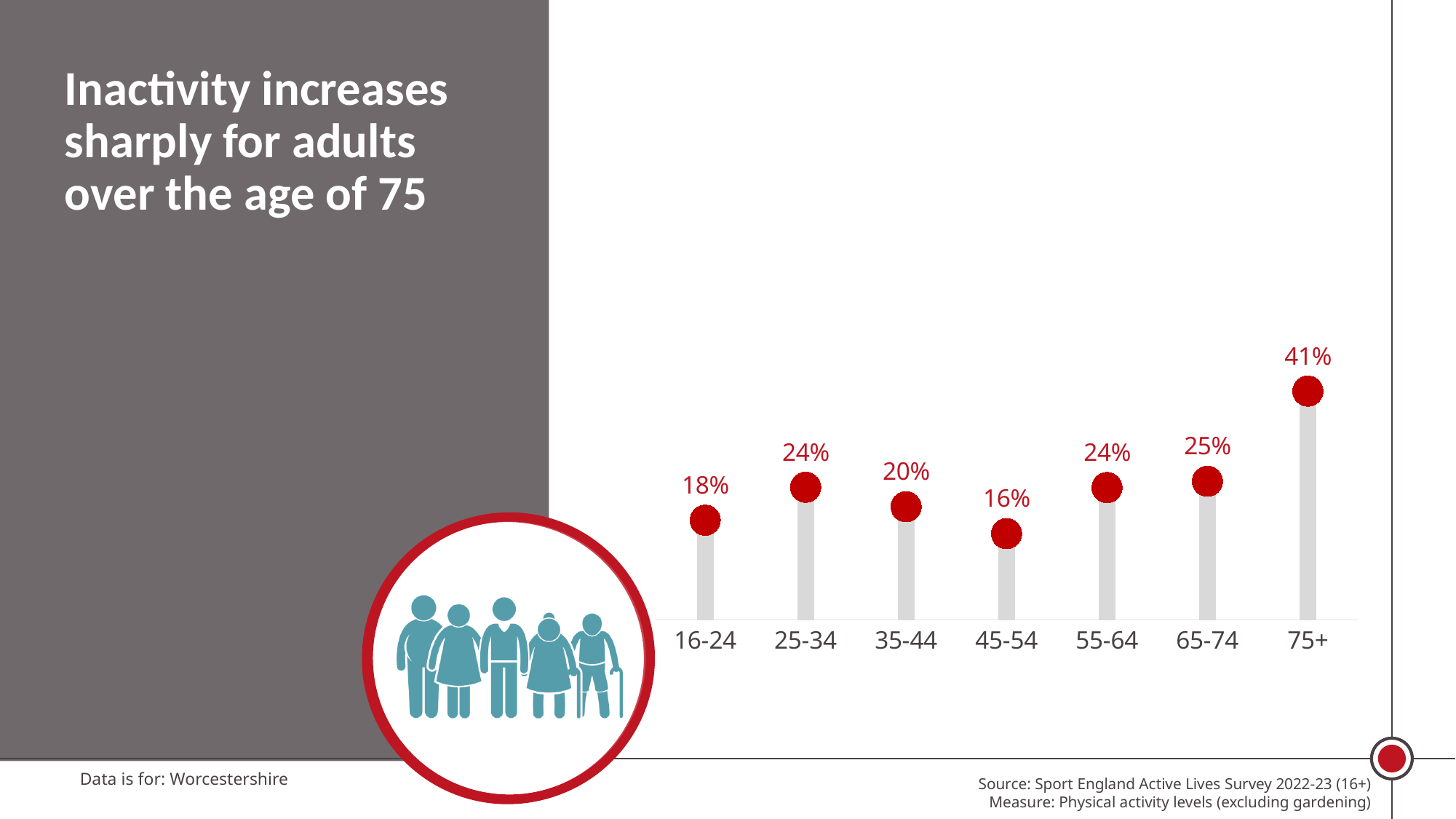
What kind of chart is shown on the slide? Bar chart How many age groups are shown on the chart? 7 Which age group has the lowest inactivity value? 45-54 What is the inactivity value for the 16-24 age group? 18% What is the inactivity value for the 45-54 age group? 16% Which age group has a larger inactivity value, 35-44 or 55-64? 55-64 What is the inactivity value for the 75+ age group? 41% Which two age groups share the same inactivity value of 24%? 25-34 and 55-64 What is the inactivity value for the 65-74 age group? 25% What is the difference between the inactivity values for the 25-34 and 35-44 age groups? 4% What is the difference between the inactivity values for the 75+ and 65-74 age groups? 16% Which age group has the highest inactivity value? 75+